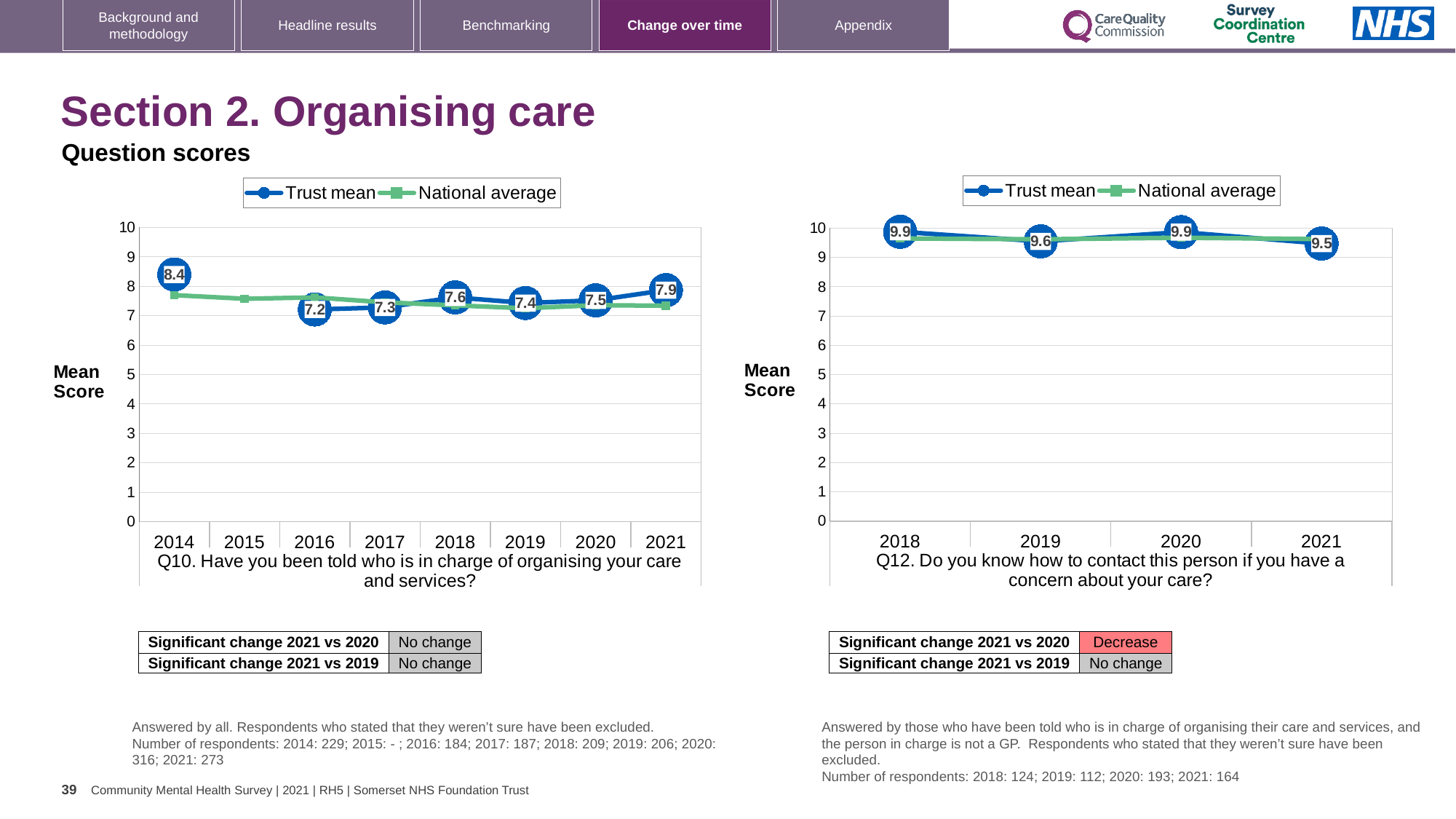
In the Q10 chart on the left, which year has the lowest Trust mean score? 2016 In the Q12 chart on the right, which is larger, the Trust mean for 2020 or for 2021? 2020 In the Q10 chart on the left, what is the Trust mean score for 2014? 8.4 In the Q10 chart on the left, is the National average value for 2014 greater or less than 7? greater In the Q12 chart on the right, how many years are shown on the x axis? 4 In the Q10 chart on the left, what is the difference between the Trust mean scores for 2021 and 2020? 0.4 In the Q10 chart on the left, which year has the highest Trust mean score? 2014 In the Q10 chart on the left, what is the Trust mean score for 2021? 7.9 How many series does the legend of the Q10 chart on the left list? 2 What kind of chart is the Q12 chart on the right? Line chart In the Q12 chart on the right, what is the Trust mean score for 2021? 9.5 In the Q12 chart on the right, what is the Trust mean score for 2019? 9.6